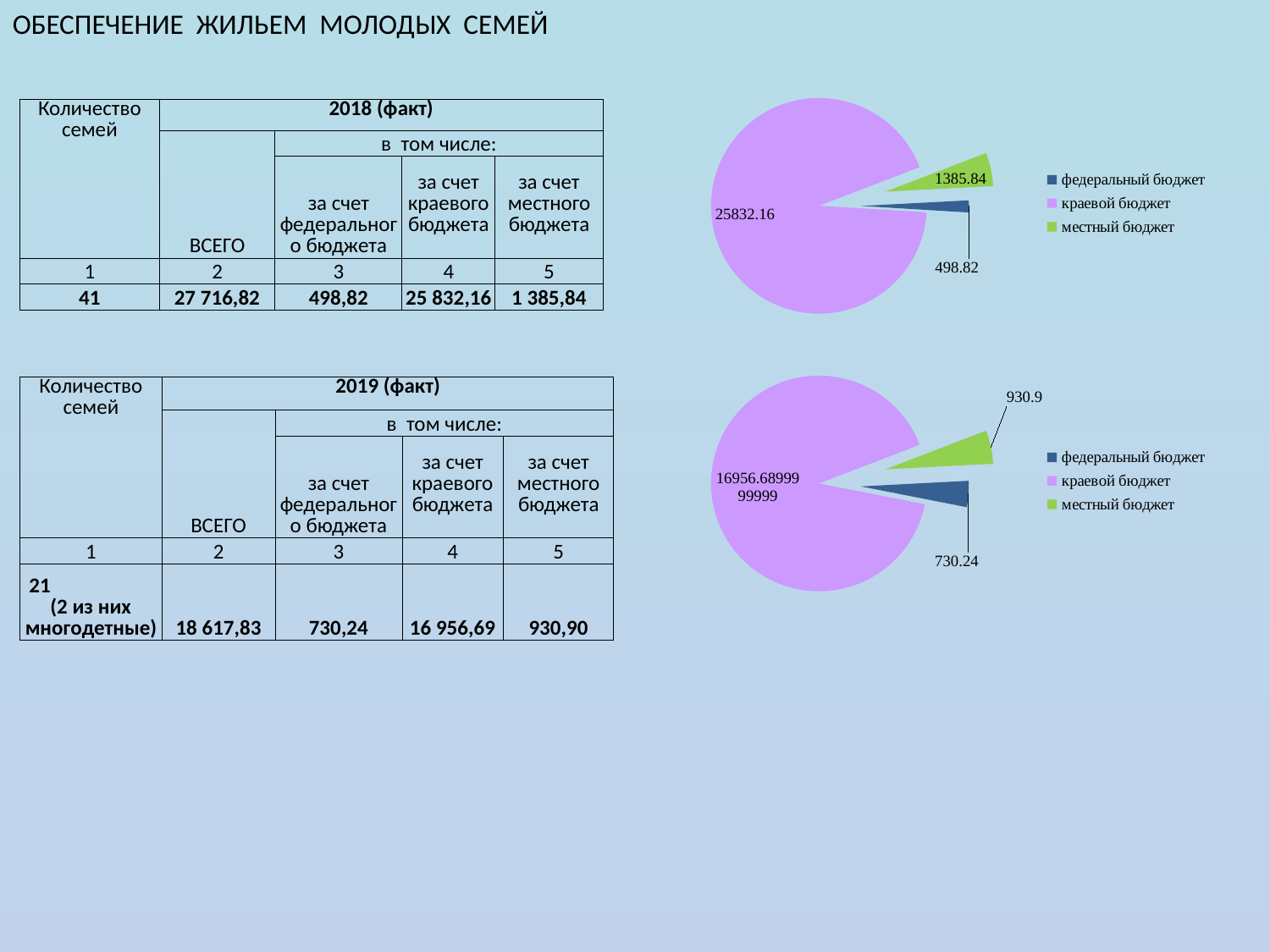
How many entries does the legend of the bottom pie chart list? 3 In the top pie chart, what is the value labelled for федеральный бюджет? 498.82 How many slices does the top pie chart have? 3 In the top pie chart, which budget has the smallest slice? федеральный бюджет In the top pie chart, what is the value labelled for местный бюджет? 1385.84 In the top pie chart, which budget has the largest slice? краевой бюджет In the top pie chart, what is the difference between the values for местный бюджет and федеральный бюджет? 887.02 In the bottom pie chart, what is the value labelled for федеральный бюджет? 730.24 In the bottom pie chart, which budget has the largest slice? краевой бюджет In the bottom pie chart, what is the value labelled for местный бюджет? 930.9 In the top pie chart, what is the value labelled for краевой бюджет? 25832.16 What kind of chart is the top chart on the right side of the slide? pie chart